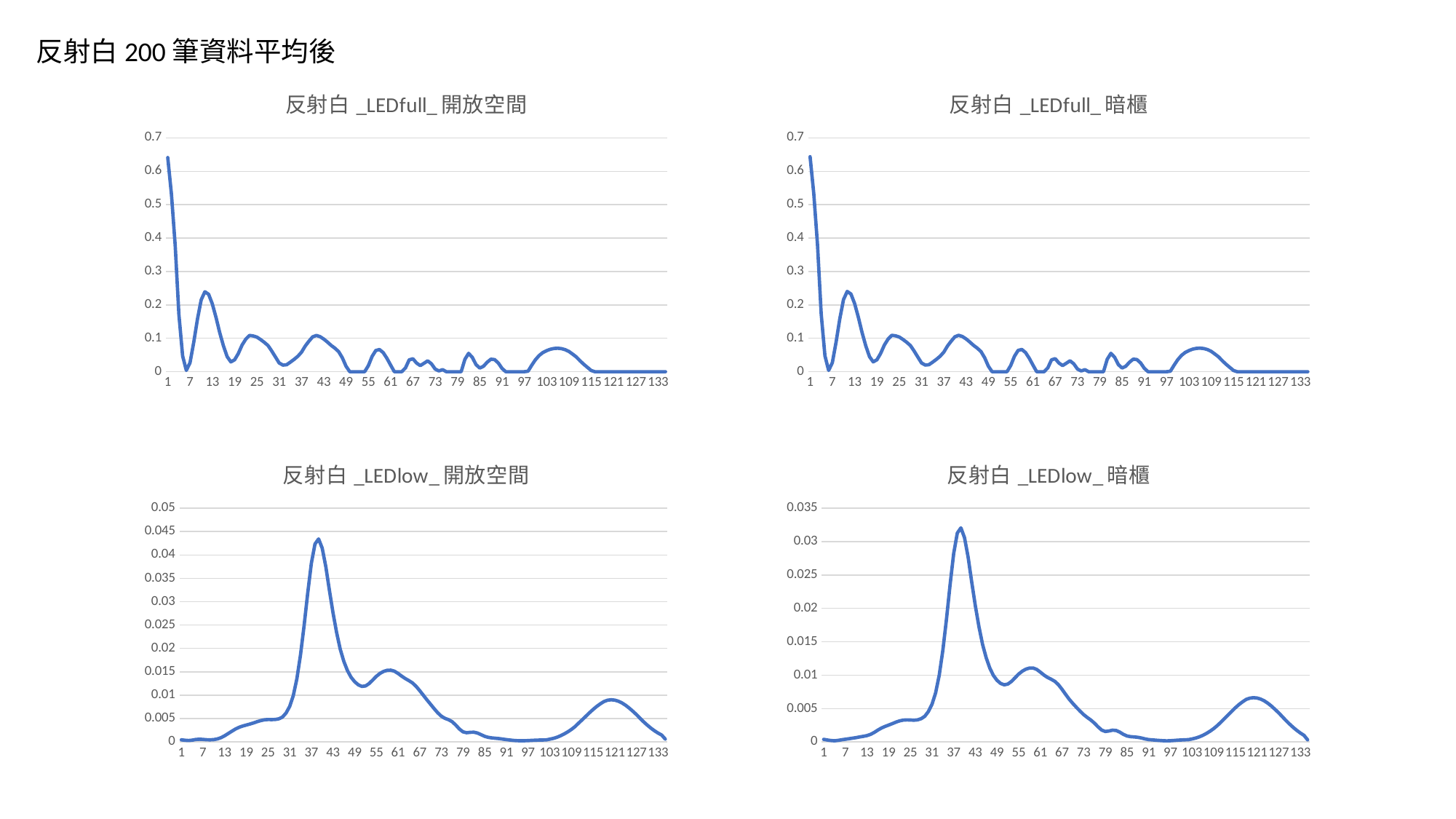
In the chart 反射白 _LEDfull_ 開放空間, which is larger: the value at x = 1 or the peak near x = 13? the value at x = 1 In the chart 反射白 _LEDfull_ 暗櫃, is the peak near x = 13 greater or less than 0.2? greater What is the top y-axis tick value on the chart 反射白 _LEDlow_ 開放空間? 0.05 In the chart 反射白 _LEDfull_ 暗櫃, does the line rise or fall from x = 1 to x = 7? fall In the chart 反射白 _LEDlow_ 開放空間, is the value at x = 121 greater or less than 0.015? less In the chart 反射白 _LEDlow_ 暗櫃, is the highest value greater or less than 0.03? greater What kind of chart is 反射白 _LEDfull_ 開放空間? line chart How many charts are shown on the slide? 4 In the chart 反射白 _LEDlow_ 暗櫃, which is larger: the peak near x = 40 or the peak near x = 121? the peak near x = 40